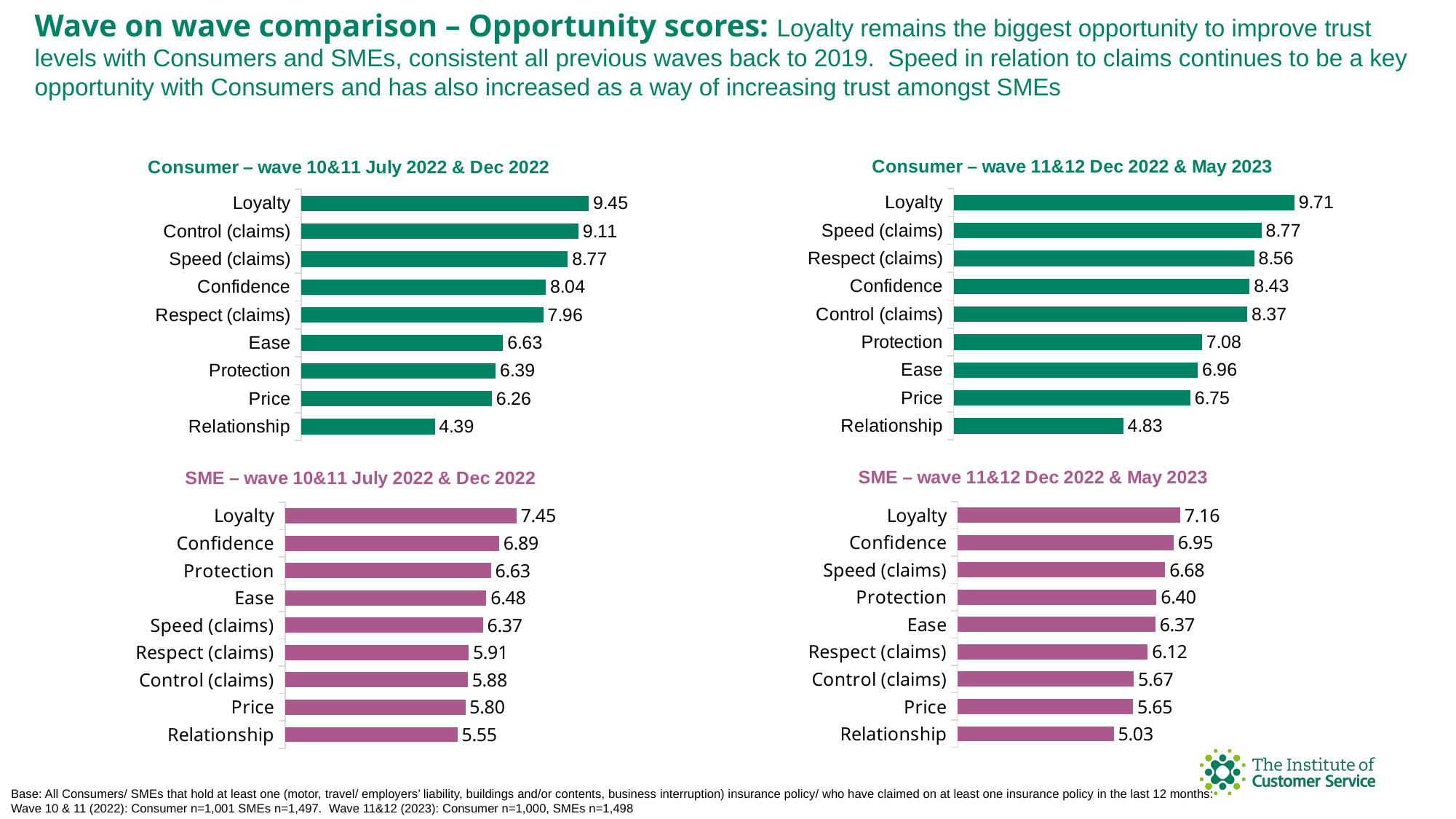
What kind of chart is the 'Consumer – wave 10&11 July 2022 & Dec 2022' chart? Bar chart In the 'SME – wave 11&12 Dec 2022 & May 2023' chart, what is the value for Relationship? 5.03 In the 'Consumer – wave 10&11 July 2022 & Dec 2022' chart, what is the difference between the values for Loyalty and Relationship? 5.06 In the 'SME – wave 10&11 July 2022 & Dec 2022' chart, what is the value for Protection? 6.63 In the 'Consumer – wave 11&12 Dec 2022 & May 2023' chart, which category has the highest value? Loyalty How many categories are shown in the 'SME – wave 10&11 July 2022 & Dec 2022' chart? 9 In the 'SME – wave 11&12 Dec 2022 & May 2023' chart, what is the difference between the values for Loyalty and Confidence? 0.21 In the 'SME – wave 10&11 July 2022 & Dec 2022' chart, which category has the lowest value? Relationship In the 'Consumer – wave 11&12 Dec 2022 & May 2023' chart, which is larger, the value for Protection or the value for Price? Protection How many charts are shown on the slide? 4 In the 'Consumer – wave 11&12 Dec 2022 & May 2023' chart, what is the value for Speed (claims)? 8.77 In the 'Consumer – wave 10&11 July 2022 & Dec 2022' chart, what is the value for Control (claims)? 9.11